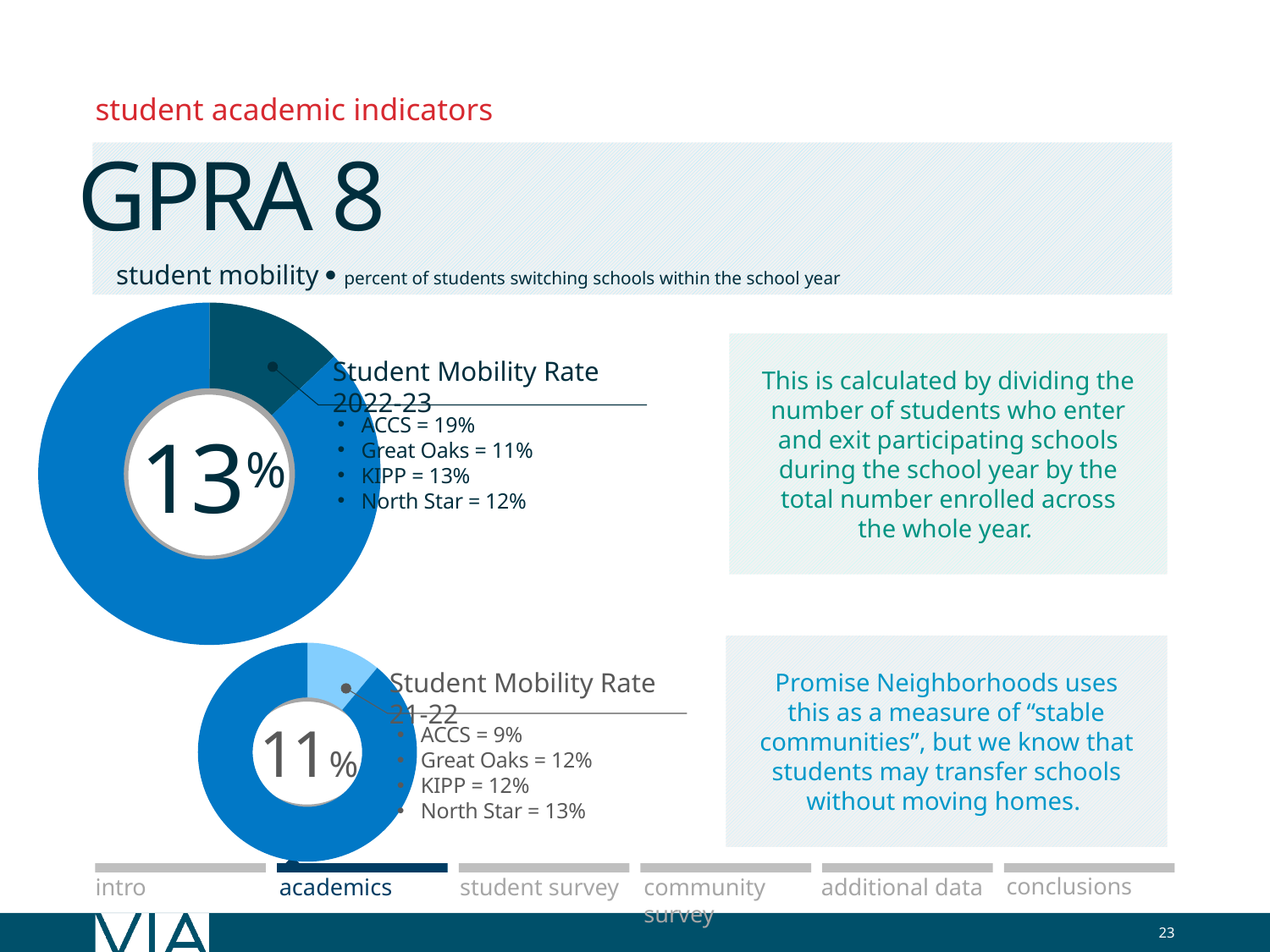
What is the difference between the ACCS mobility rate in 2022-23 and in 21-22? 10% What overall student mobility rate is shown in the centre of the Student Mobility Rate 2022-23 donut chart? 13% What kind of chart is used to show the Student Mobility Rate 2022-23? Donut chart In the Student Mobility Rate 2022-23 list, which school has the highest mobility rate? ACCS In the Student Mobility Rate 21-22 list, which school has the lowest mobility rate? ACCS In the Student Mobility Rate 2022-23 list, what is the value for ACCS? 19% How many donut charts are shown on the slide? 2 Which is larger: the overall mobility rate in the 2022-23 donut chart or in the 21-22 donut chart? 2022-23 What overall student mobility rate is shown in the centre of the Student Mobility Rate 21-22 donut chart? 11% In the Student Mobility Rate 2022-23 list, what is the value for Great Oaks? 11% In the Student Mobility Rate 21-22 list, what is the value for North Star? 13% How many schools are listed next to the Student Mobility Rate 2022-23 chart? 4